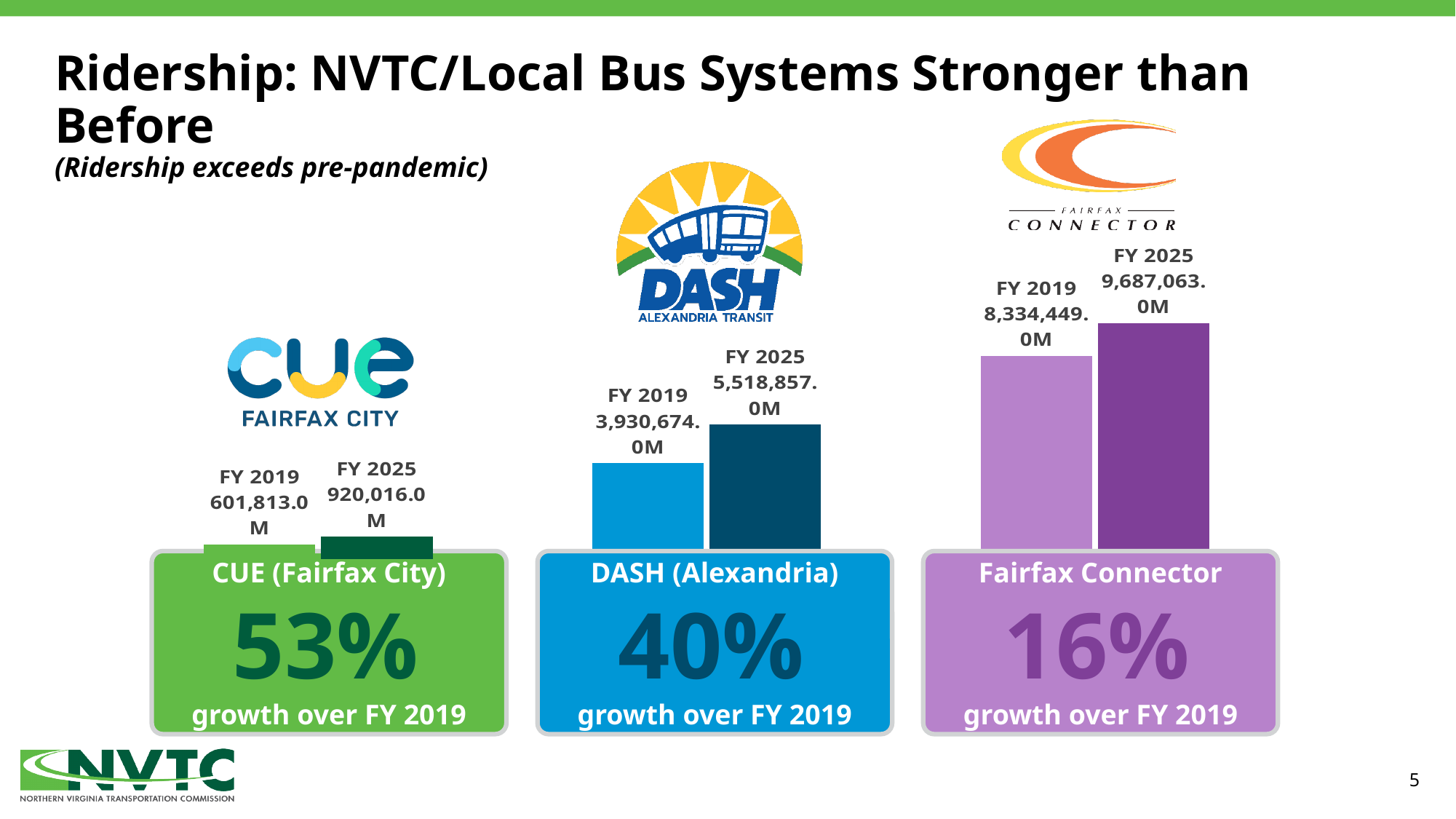
In the CUE (Fairfax City) chart, what is the ridership value for FY 2025? 920,016.0M What kind of chart is used for the Fairfax Connector ridership? Bar chart In the DASH (Alexandria) chart, what is the difference between the FY 2025 and FY 2019 values? 1,588,183.0M In the Fairfax Connector chart, what is the difference between the FY 2025 and FY 2019 values? 1,352,614.0M In the DASH (Alexandria) chart, what is the ridership value for FY 2025? 5,518,857.0M In the Fairfax Connector chart, what is the ridership value for FY 2025? 9,687,063.0M In the Fairfax Connector chart, what is the ridership value for FY 2019? 8,334,449.0M In the CUE (Fairfax City) chart, which year has the higher value, FY 2019 or FY 2025? FY 2025 In the DASH (Alexandria) chart, what is the ridership value for FY 2019? 3,930,674.0M In the Fairfax Connector chart, do the values rise or fall from FY 2019 to FY 2025? Rise In the CUE (Fairfax City) chart, what is the ridership value for FY 2019? 601,813.0M How many bars are shown in the DASH (Alexandria) chart? 2